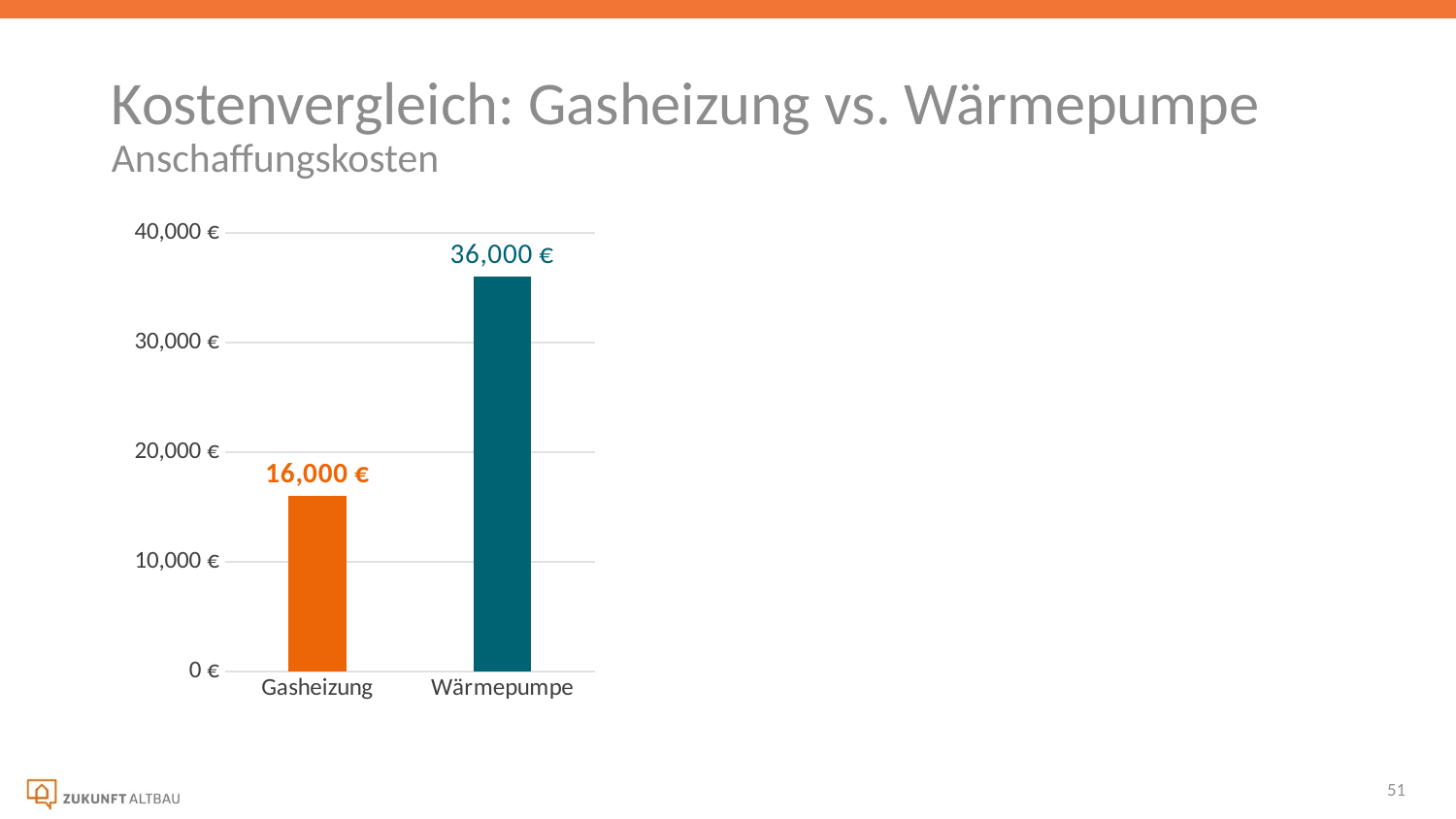
Which category has the lowest value? Gasheizung Is the value for Wärmepumpe greater or less than 30,000 €? greater What colour is the bar for Gasheizung? orange What is the value for Gasheizung? 16,000 € What is the title of the slide? Kostenvergleich: Gasheizung vs. Wärmepumpe What is the value for Wärmepumpe? 36,000 € What is the difference between the values for Wärmepumpe and Gasheizung? 20,000 € Which category has the highest value? Wärmepumpe Is the value for Gasheizung greater or less than 20,000 €? less What kind of chart is shown on the slide? bar chart Which is larger, the value for Gasheizung or the value for Wärmepumpe? Wärmepumpe How many categories are shown in the chart? 2